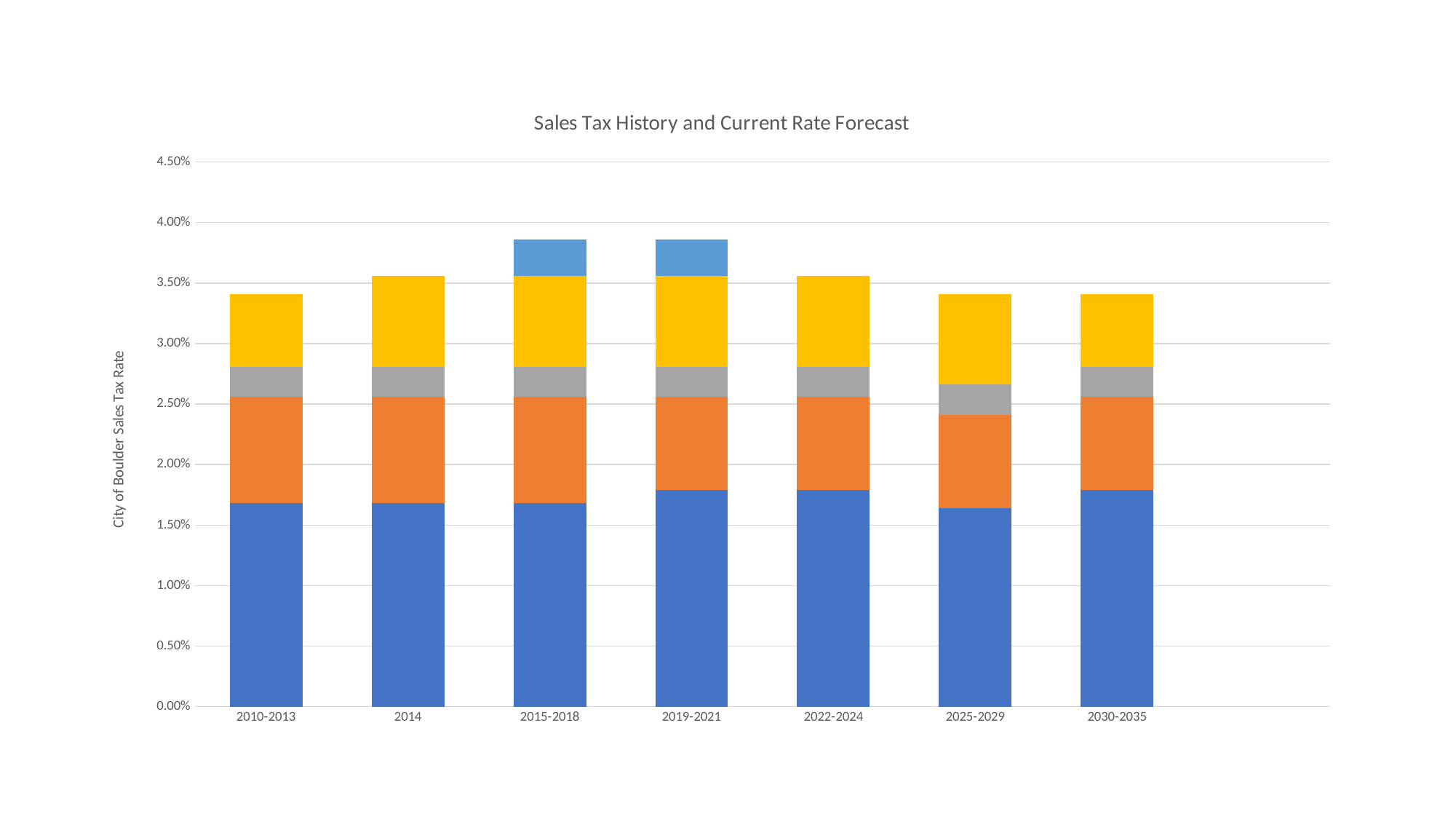
Do the total stacked values rise or fall from 2010-2013 to 2015-2018? rise What kind of chart is shown on the slide? Stacked bar chart How many time-period categories are shown on the x axis? 7 Which has the larger total stacked value, 2010-2013 or 2014? 2014 What is the title of the chart? Sales Tax History and Current Rate Forecast Is the total stacked value for 2025-2029 greater or less than 3.00%? greater Do the total stacked values rise or fall from 2019-2021 to 2025-2029? fall What is the label on the vertical axis? City of Boulder Sales Tax Rate Is the total stacked value for 2015-2018 greater or less than 3.50%? greater Is the total stacked value for 2019-2021 greater or less than 4.00%? less Which has the larger total stacked value, 2014 or 2015-2018? 2015-2018